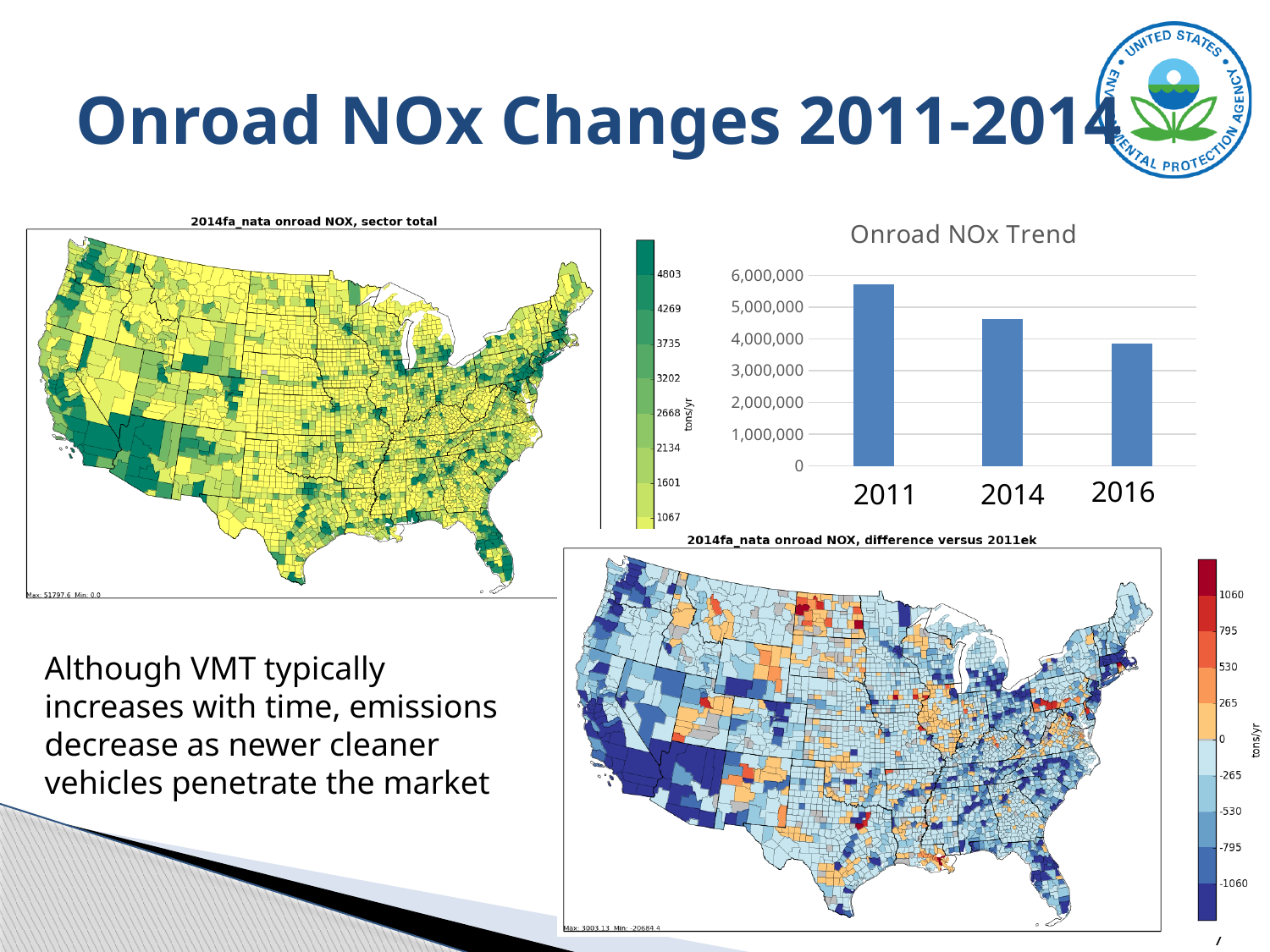
In the "Onroad NOx Trend" chart, do the values rise or fall from 2011 to 2016? fall How many years are plotted in the "Onroad NOx Trend" chart? 3 In the "Onroad NOx Trend" chart, is the value for 2014 greater or less than 4,000,000? greater In the "Onroad NOx Trend" chart, which year has the lowest value? 2016 What kind of chart is the "Onroad NOx Trend" chart? bar chart In the "Onroad NOx Trend" chart, is the value for 2011 greater or less than 5,000,000? greater What is the title of the bar chart on the slide? Onroad NOx Trend In the "Onroad NOx Trend" chart, which year has the highest value? 2011 In the "Onroad NOx Trend" chart, which is larger, the value for 2011 or the value for 2016? 2011 What is the highest tick value shown on the vertical axis of the "Onroad NOx Trend" chart? 6,000,000 In the "Onroad NOx Trend" chart, is the value for 2016 greater or less than 3,000,000? greater